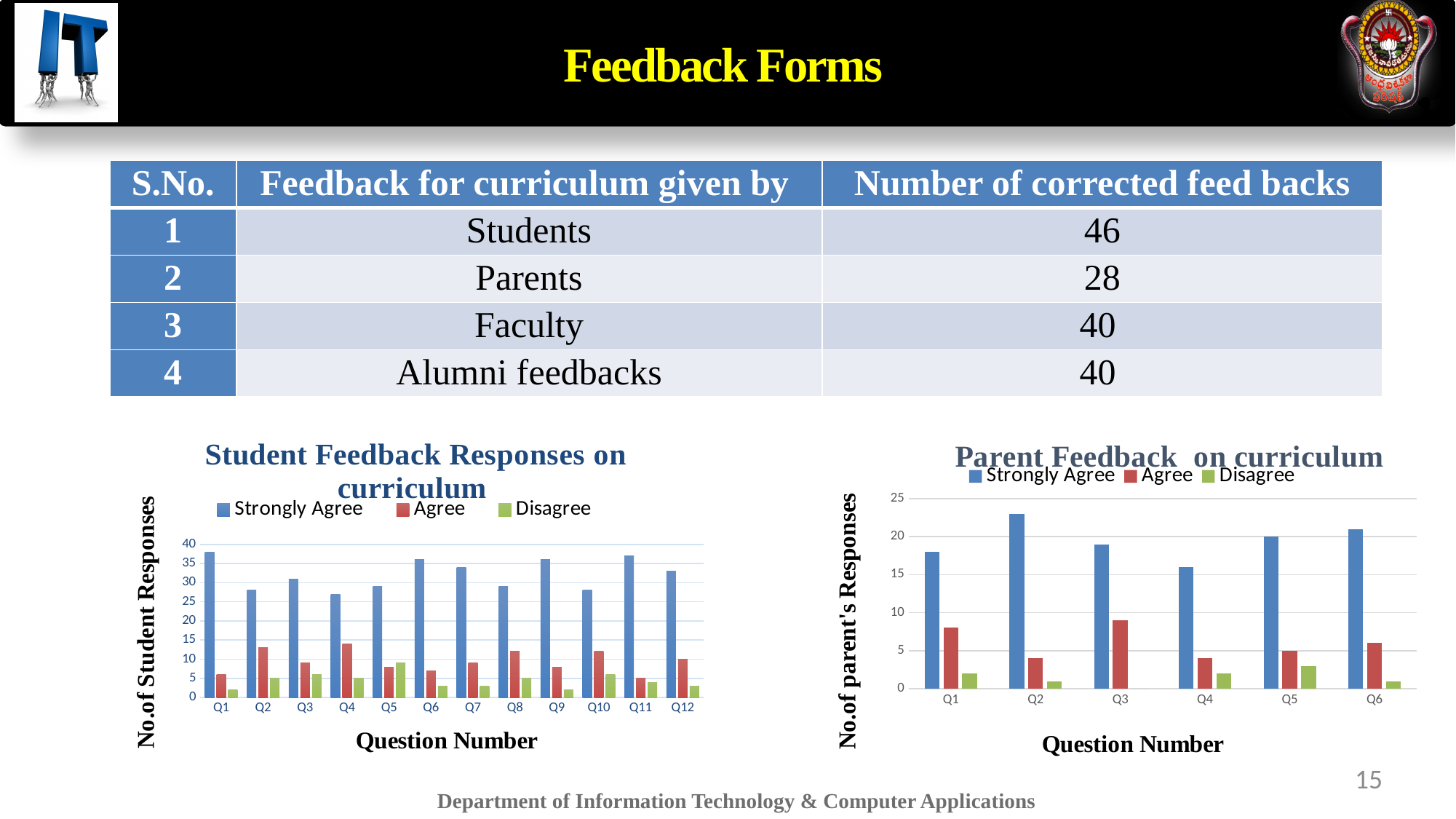
How many series does the legend of the 'Parent Feedback on curriculum' chart list? 3 How many question numbers are shown on the x axis of the 'Parent Feedback on curriculum' chart? 6 In the 'Student Feedback Responses on curriculum' chart, is the Strongly Agree value for Q1 greater or less than 35? greater What is the y-axis title of the 'Parent Feedback on curriculum' chart? No.of parent's Responses In the 'Parent Feedback on curriculum' chart, is the Strongly Agree value for Q2 greater or less than 20? greater In the 'Parent Feedback on curriculum' chart, which question has the lowest Strongly Agree value? Q4 In the 'Student Feedback Responses on curriculum' chart, is the Agree value for Q4 greater or less than 10? greater What kind of chart is the 'Student Feedback Responses on curriculum' chart? bar chart In the 'Student Feedback Responses on curriculum' chart, which is larger: the Strongly Agree value for Q1 or for Q4? Q1 How many question numbers are shown on the x axis of the 'Student Feedback Responses on curriculum' chart? 12 In the 'Parent Feedback on curriculum' chart, which question has the highest Strongly Agree value? Q2 In the 'Student Feedback Responses on curriculum' chart, which question has the highest Disagree value? Q5